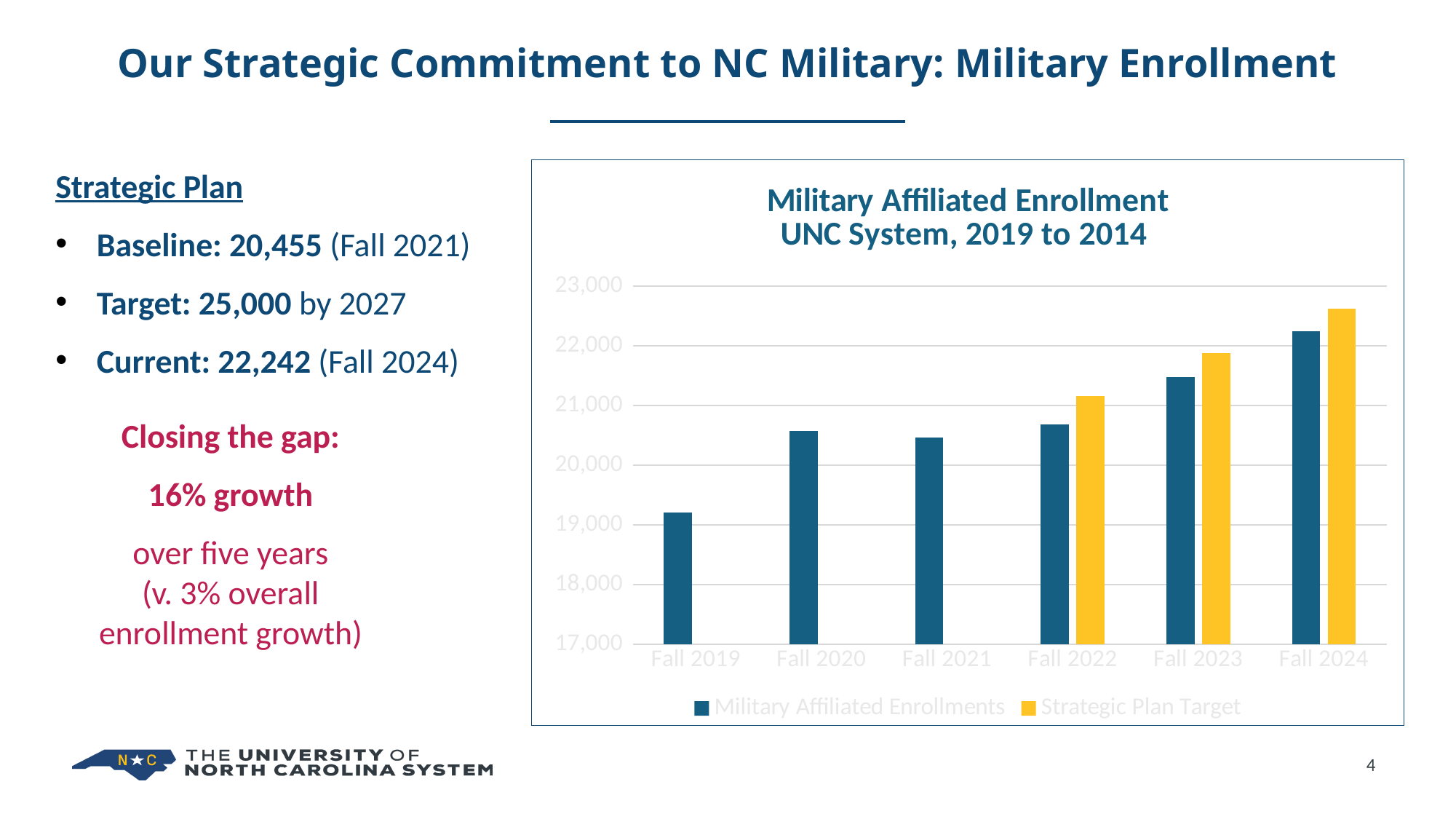
Which fall term has the lowest Military Affiliated Enrollments bar? Fall 2019 Is the Strategic Plan Target value for Fall 2024 greater or less than 23,000? less How many series does the chart legend list? 2 Is the Military Affiliated Enrollments value for Fall 2019 greater or less than 19,000? greater Do the Military Affiliated Enrollments values generally rise or fall from Fall 2019 to Fall 2024? rise What kind of chart is shown on the slide? bar chart How many fall terms are shown on the x axis of the chart? 6 Which colour represents the Strategic Plan Target series in the chart? yellow For Fall 2023, which is larger: the Military Affiliated Enrollments bar or the Strategic Plan Target bar? Strategic Plan Target Is the Strategic Plan Target value for Fall 2023 greater or less than 22,000? less Which fall term has the highest Military Affiliated Enrollments bar? Fall 2024